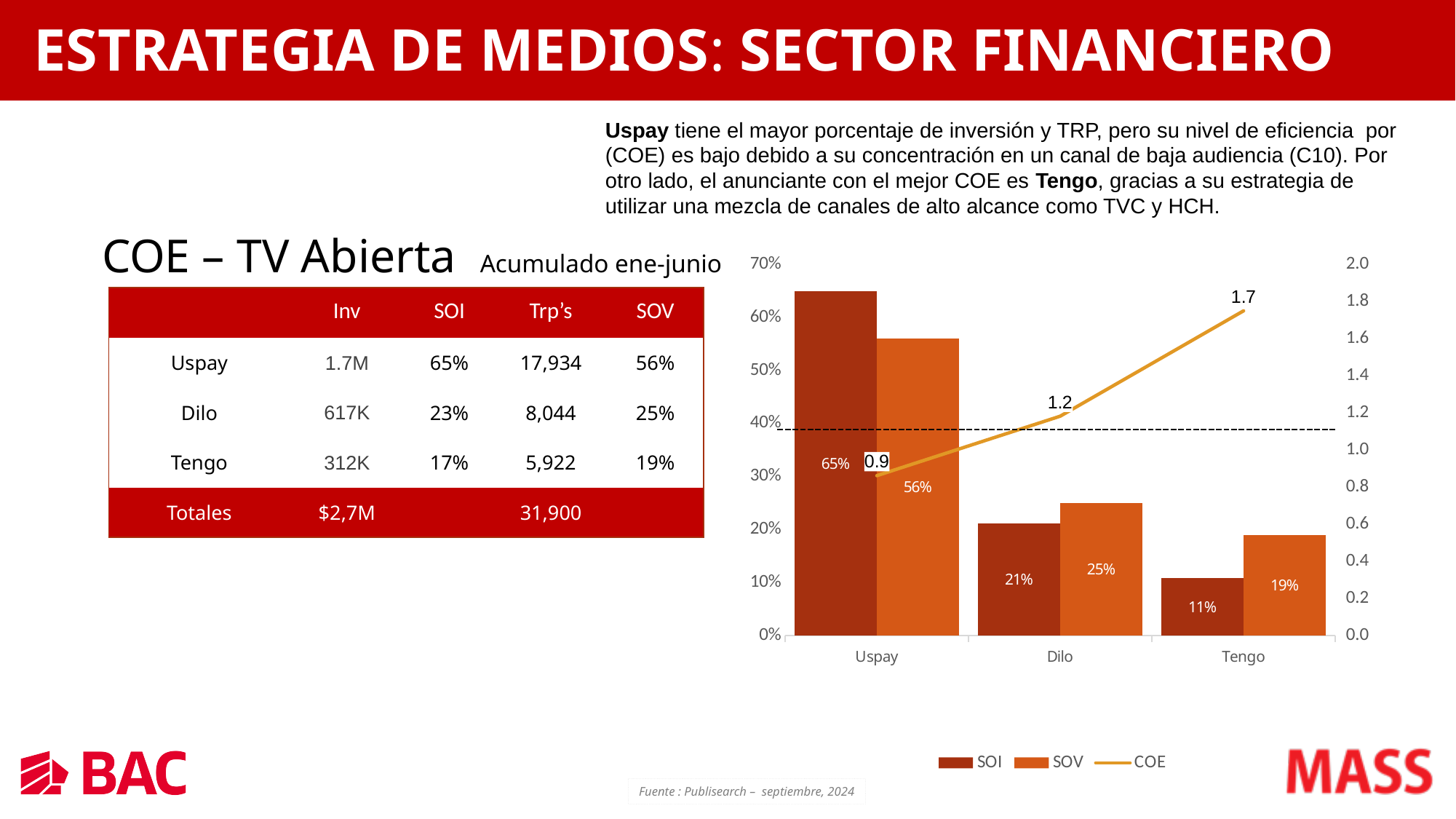
How many categories are shown on the x axis of the chart? 3 How many series does the chart legend list? 3 Which is larger for Dilo in the chart, SOI or SOV? SOV What is the SOI value for Tengo in the chart? 11% What is the COE value for Tengo in the chart? 1.7 Does the COE line rise or fall from Uspay to Tengo in the chart? rise Which category has the highest COE value in the chart? Tengo What is the SOV value for Dilo in the chart? 25% Which series in the chart is drawn as a line rather than bars? COE Which category has the lowest SOV value in the chart? Tengo What is the difference between the SOI and SOV values for Uspay in the chart? 9% What is the SOI value for Uspay in the chart? 65%